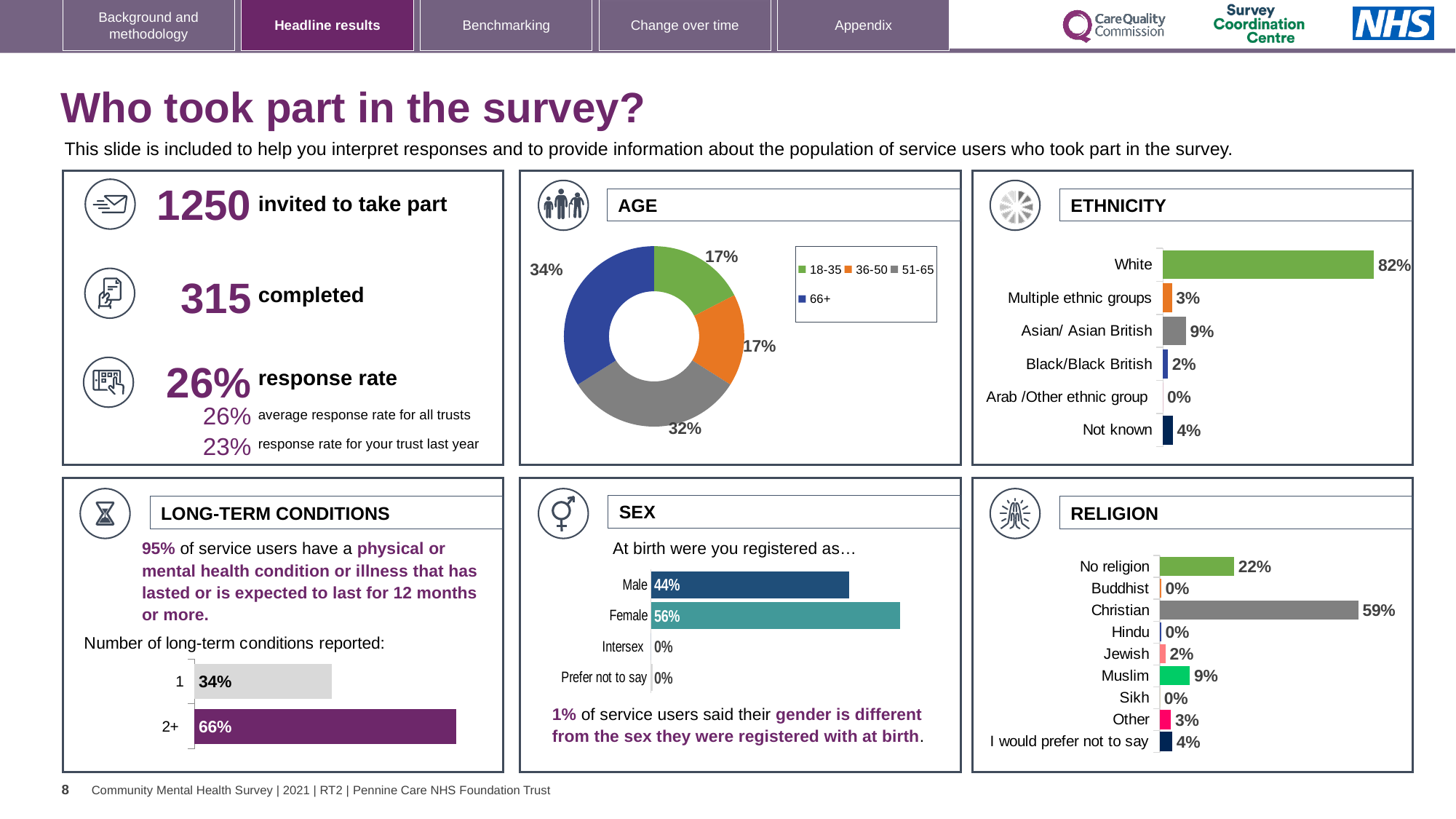
In the LONG-TERM CONDITIONS chart, what percentage of service users reported 2+ conditions? 66% In the AGE chart, what share of respondents were aged 66+? 34% In the ETHNICITY chart, what is the value for Asian/ Asian British? 9% In the ETHNICITY chart, which category has the highest value? White In the RELIGION chart, which category has the highest value? Christian How many categories are shown in the ETHNICITY chart? 6 How many age groups does the legend of the AGE chart list? 4 In the RELIGION chart, what is the value for Muslim? 9% In the ETHNICITY chart, what is the difference between White and Not known? 78% In the SEX chart, what is the difference between Female and Male? 12% What kind of chart is the AGE chart? Donut (pie) chart In the SEX chart, which is larger, Male or Female? Female